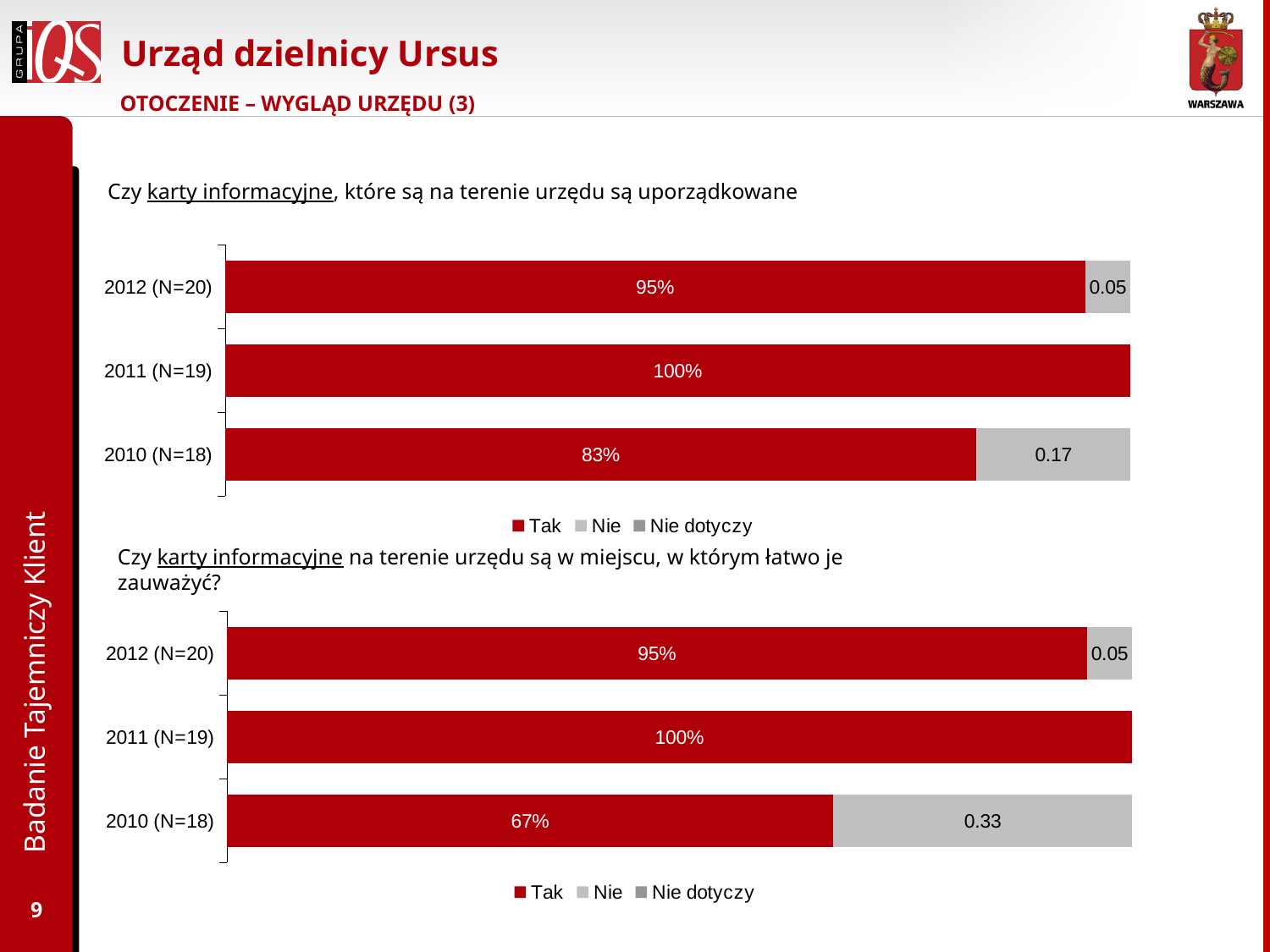
In the bottom chart, is the 'Tak' value larger for 2012 (N=20) or for 2010 (N=18)? 2012 (N=20) In the top chart, what is the difference between the 'Tak' values for 2011 (N=19) and 2010 (N=18)? 17% In the top chart, what is the 'Tak' value for 2012 (N=20)? 95% How many series does the legend of the top chart list? 3 How many year categories does the bottom chart show? 3 In the bottom chart, which legend entry is shown in red? Tak In the top chart, what is the 'Nie' value for 2010 (N=18)? 0.17 In the top chart, which year has the highest 'Tak' value? 2011 (N=19) What type of chart is the top chart? Stacked bar chart In the bottom chart, what is the 'Nie' value for 2010 (N=18)? 0.33 In the bottom chart, what is the 'Tak' value for 2010 (N=18)? 67% In the bottom chart, which year has the lowest 'Tak' value? 2010 (N=18)